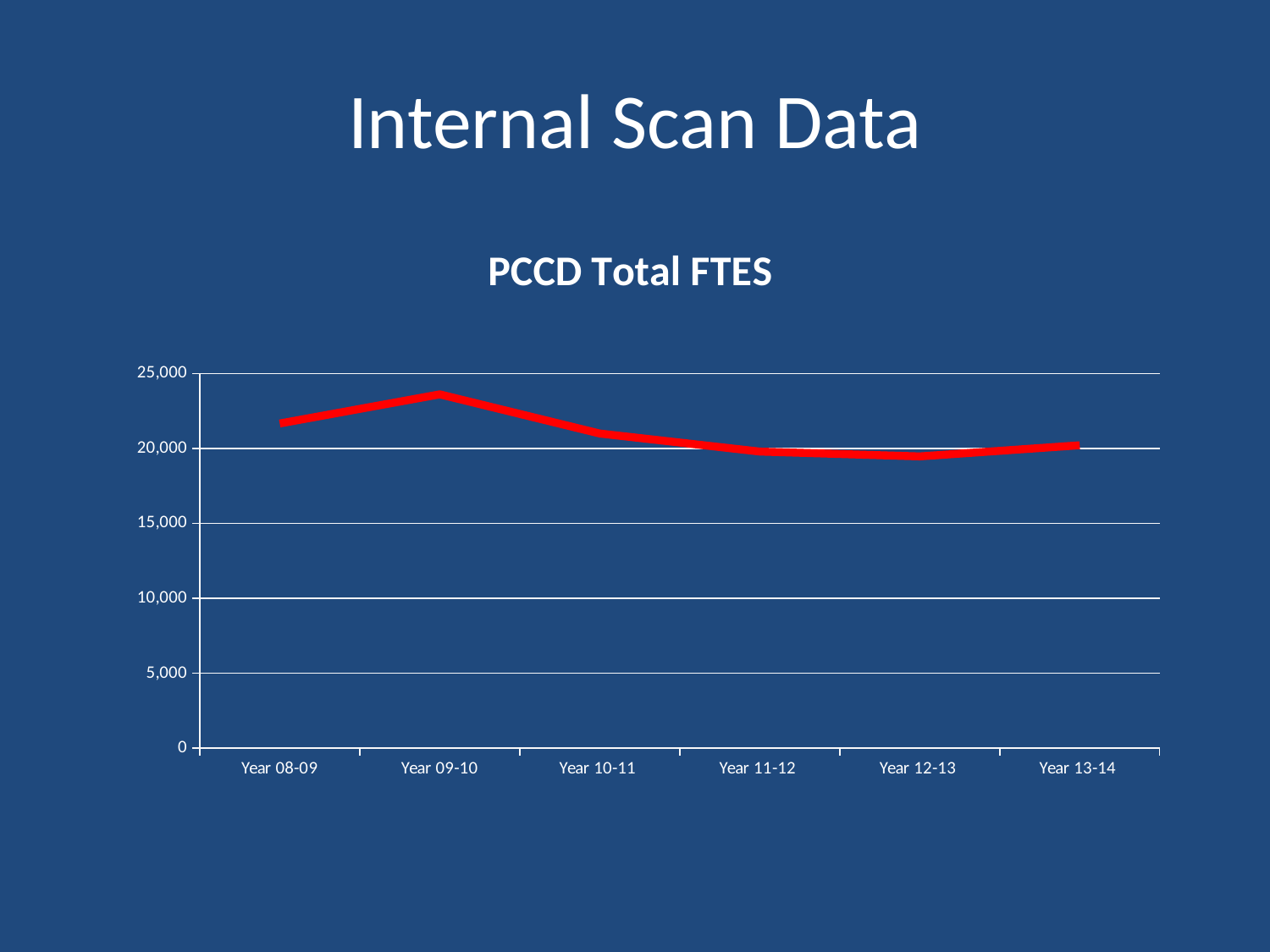
Which is larger, the value for Year 08-09 or the value for Year 11-12? Year 08-09 Which is larger, the value for Year 09-10 or the value for Year 12-13? Year 09-10 What colour is the line in the chart? red Is the value for Year 09-10 greater or less than 20,000? greater Is the value for Year 10-11 greater or less than 25,000? less How many years are plotted on the x axis? 6 Which year has the highest PCCD Total FTES? Year 09-10 What type of chart is shown on the slide? line chart Is the value for Year 08-09 greater or less than 20,000? greater Do the values rise or fall from Year 09-10 to Year 12-13? fall What is the title of the chart? PCCD Total FTES